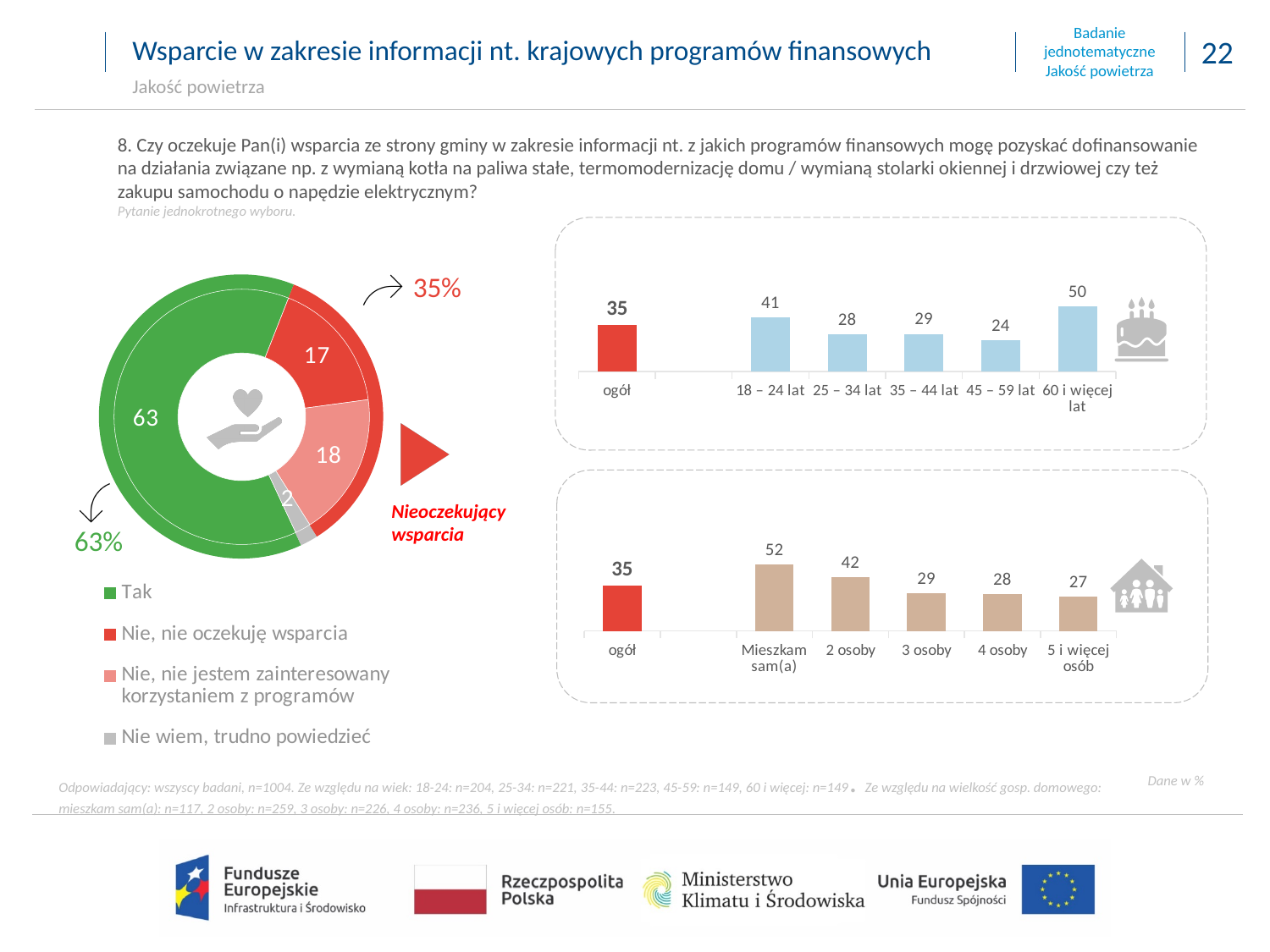
How many entries does the legend of the donut chart on the left list? 4 In the bottom-right bar chart by household size, which is larger: the value for "2 osoby" or the value for "3 osoby"? 2 osoby In the donut chart on the left, what is the value for "Tak"? 63 In the bottom-right bar chart by household size, which category has the highest value? Mieszkam sam(a) In the top-right bar chart by age, which age group has the lowest value? 45 – 59 lat In the top-right bar chart by age, what is the difference between the values for "18 – 24 lat" and "25 – 34 lat"? 13 What type of chart is the bottom-right chart by household size? Bar chart In the top-right bar chart by age, what is the value for "60 i więcej lat"? 50 In the bottom-right bar chart by household size, what is the value for "Mieszkam sam(a)"? 52 In the donut chart on the left, which category has the smallest value? Nie wiem, trudno powiedzieć In the top-right bar chart by age, what is the value for "ogół"? 35 In the donut chart on the left, what is the value for "Nie, nie jestem zainteresowany korzystaniem z programów"? 18